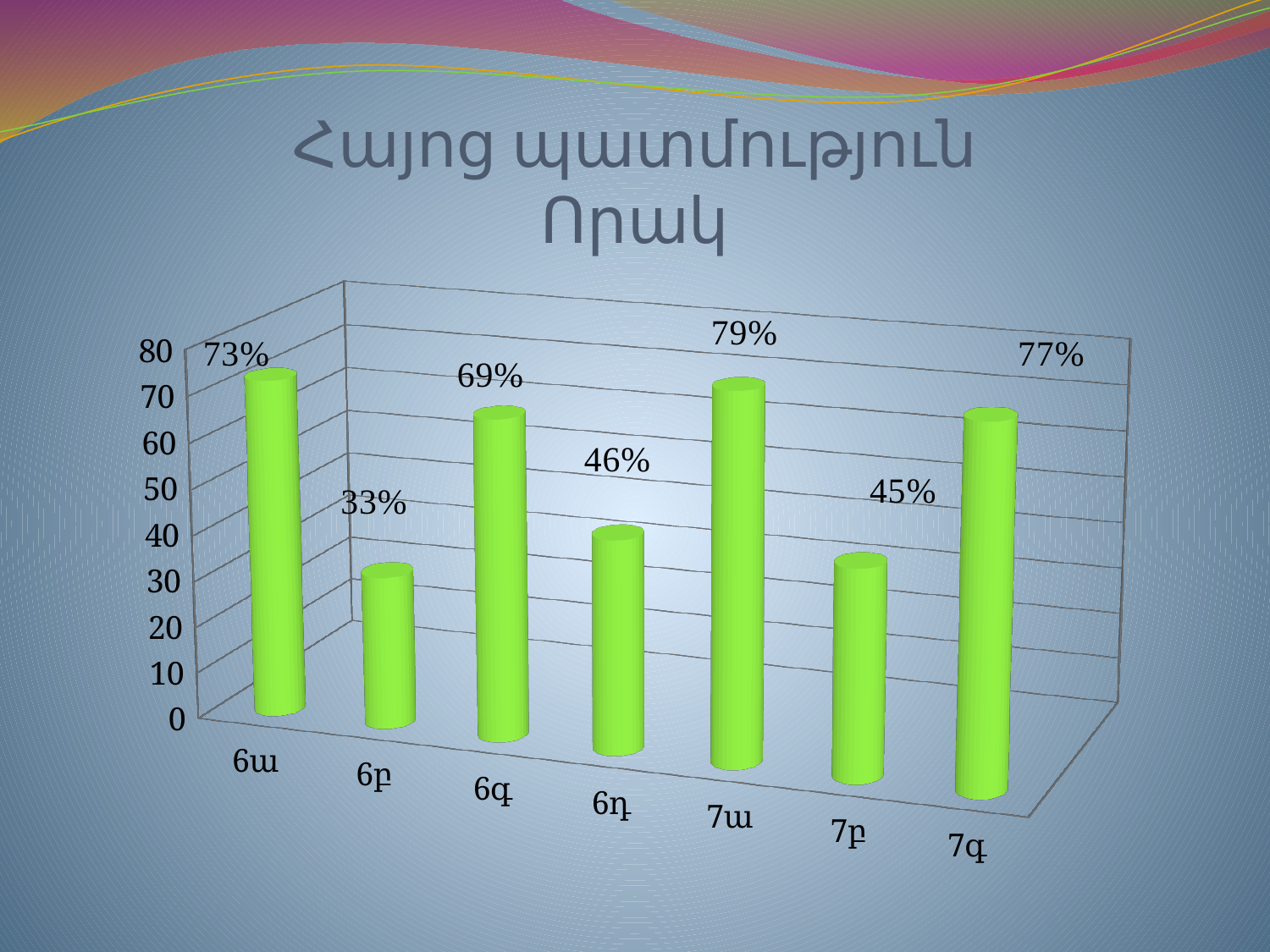
What is the value for 6գ? 69% Which category has the highest value? 7ա What is the title of the chart on the slide? Հայոց պատմություն Որակ What is the difference between the values for 6ա and 6դ? 27% What is the value for 7բ? 45% What is the value for 6ա? 73% Is the value for 6դ greater or less than 50? less How many categories are shown on the x axis? 7 What is the difference between the values for 7ա and 6բ? 46% What kind of chart is shown on the slide? bar chart Which category has the lowest value? 6բ Which is larger, the value for 6գ or the value for 7գ? 7գ